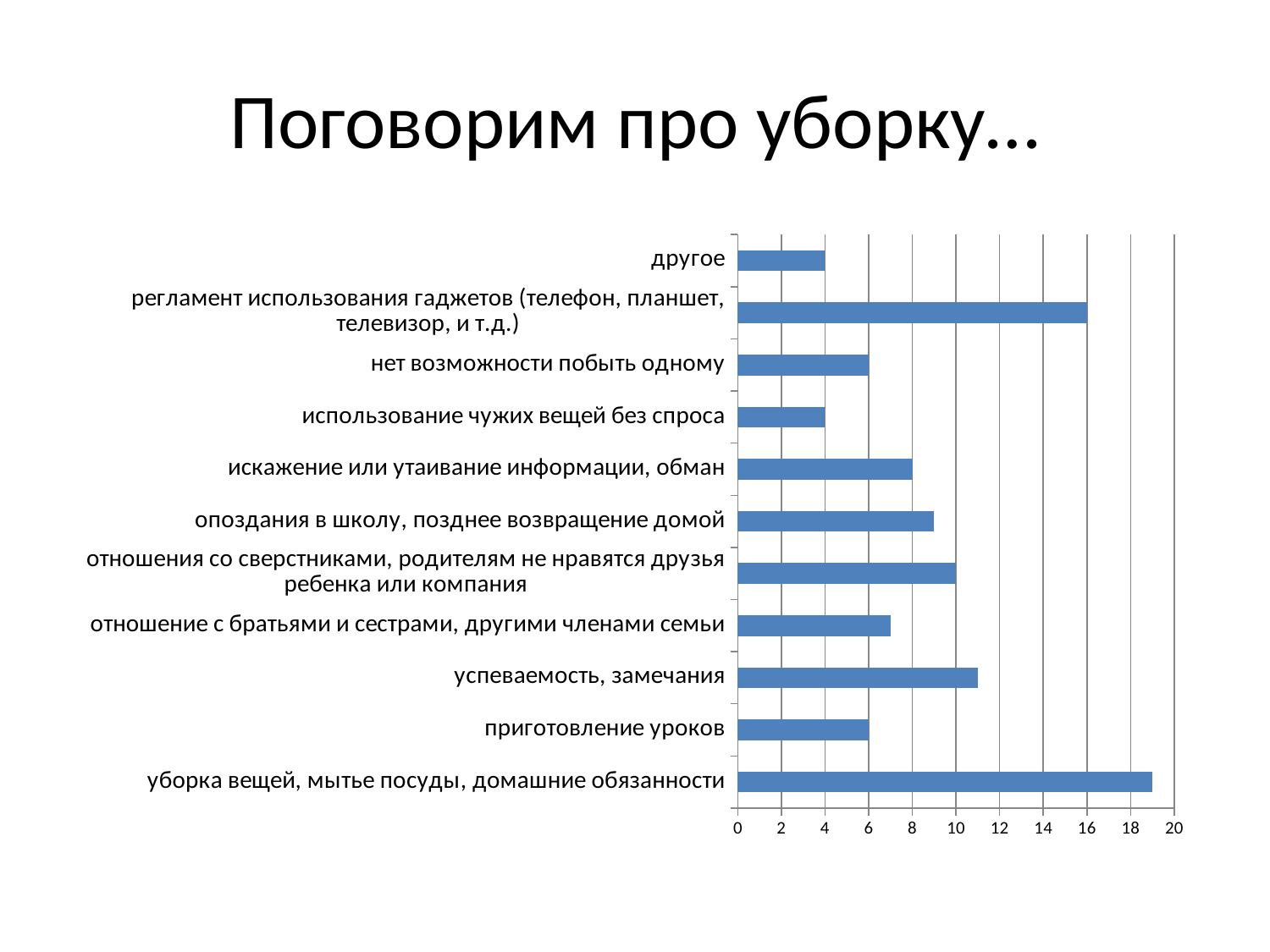
Is the value for "успеваемость, замечания" greater or less than 10? greater Which is larger: the value for "опоздания в школу, позднее возвращение домой" or the value for "нет возможности побыть одному"? опоздания в школу, позднее возвращение домой What is the value for "регламент использования гаджетов (телефон, планшет, телевизор, и т.д.)"? 16 Is the value for "уборка вещей, мытье посуды, домашние обязанности" greater or less than 18? greater What kind of chart is shown on the slide? bar chart What is the value for "искажение или утаивание информации, обман"? 8 How many categories are plotted in the chart? 11 Is the value for "отношение с братьями и сестрами, другими членами семьи" greater or less than 8? less What is the value for "приготовление уроков"? 6 What is the value for "отношения со сверстниками, родителям не нравятся друзья ребенка или компания"? 10 What is the title of the slide containing the chart? Поговорим про уборку… Which category has the highest value in the chart? уборка вещей, мытье посуды, домашние обязанности